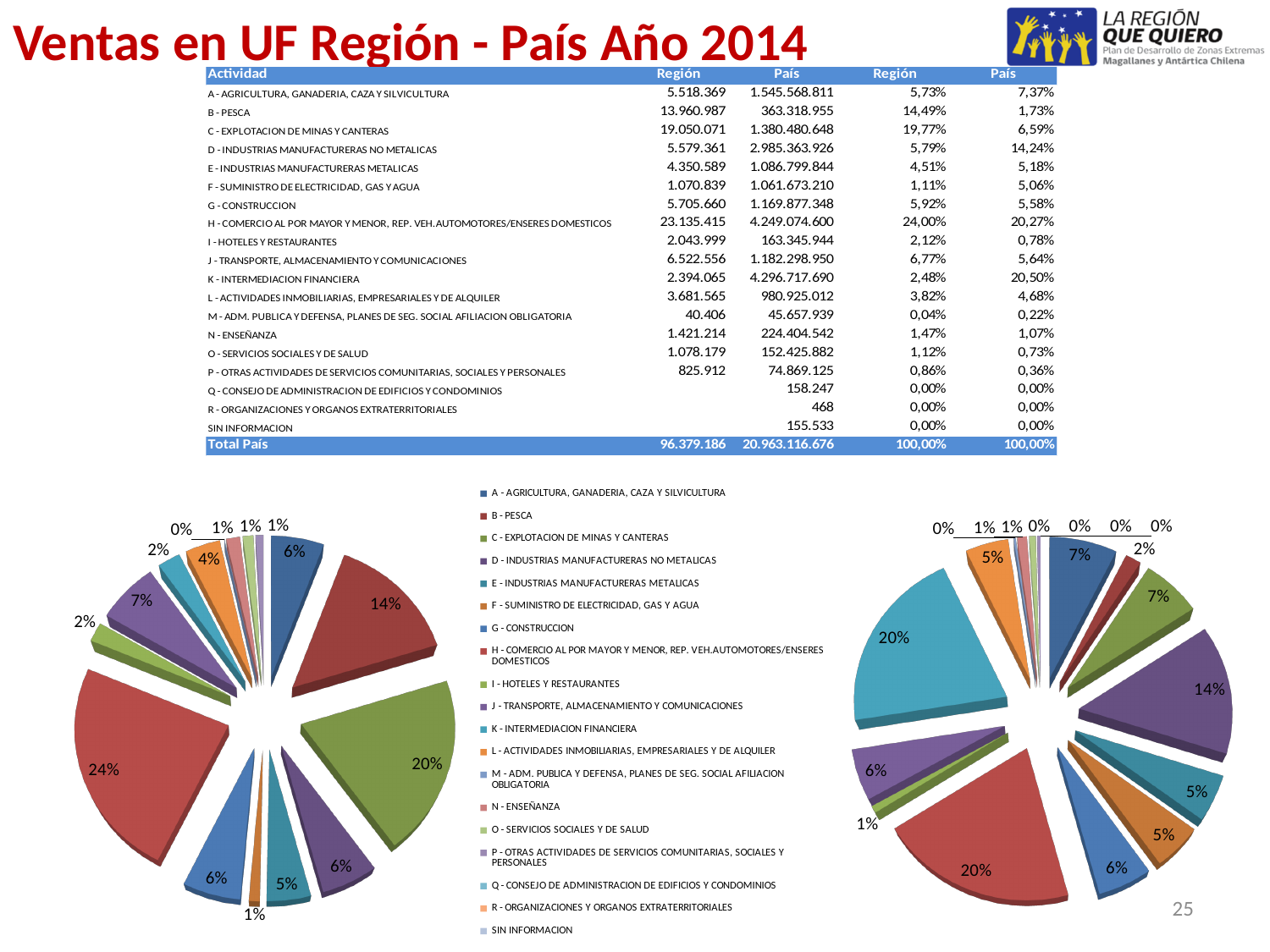
In the right pie chart, what share is shown for D - INDUSTRIAS MANUFACTURERAS NO METALICAS? 14% In the left pie chart, what is the share of the largest slice? 24% In the left pie chart, what share is shown for B - PESCA? 14% In the right pie chart, how many slices are labelled 20%? 2 In the left pie chart, which category does the largest slice (24%) represent? H - COMERCIO AL POR MAYOR Y MENOR, REP. VEH.AUTOMOTORES/ENSERES DOMESTICOS How many categories does the legend between the two pie charts list? 19 In the right pie chart, what is the largest share label shown? 20% What is the first entry in the legend between the two pie charts? A - AGRICULTURA, GANADERIA, CAZA Y SILVICULTURA What is the last entry in the legend between the two pie charts? SIN INFORMACION In the left pie chart, what is the difference between the 24% slice and the 14% slice? 10 percentage points Which is larger: the largest slice of the left pie chart or the largest slice of the right pie chart? the left pie chart (24%) What kind of chart is the left chart on the slide? pie chart